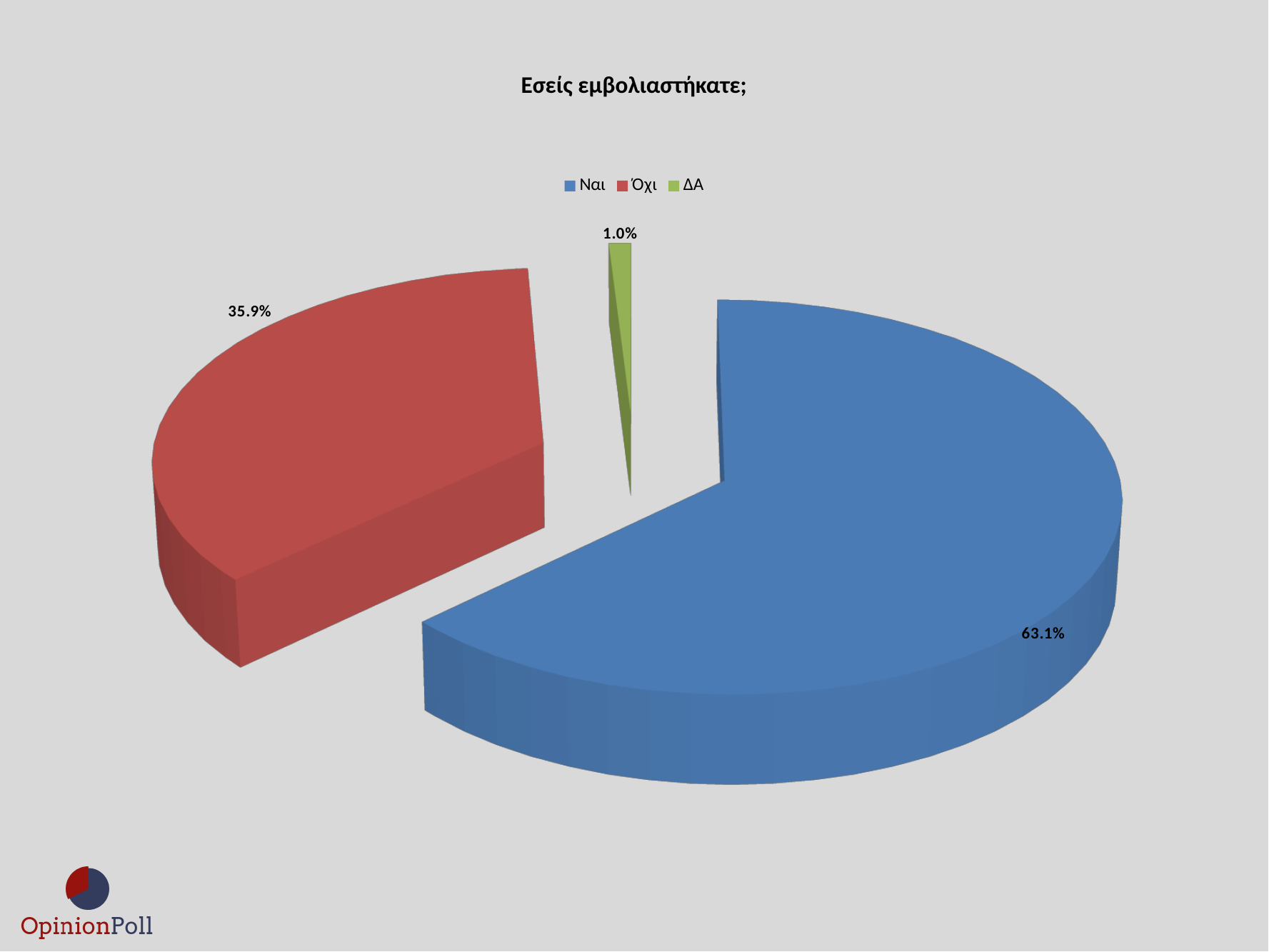
Which is larger, the Όχι slice or the ΔΑ slice? Όχι Which category has the smallest slice of the pie? ΔΑ Is the value for Ναι greater or less than 50%? greater How many categories does the legend list? 3 Which category has the largest slice of the pie? Ναι What is the difference in percentage points between the Ναι and Όχι slices? 27.2 What kind of chart is shown on the slide? pie chart What is the title of the chart? Εσείς εμβολιαστήκατε; What percentage of the pie is the Όχι slice? 35.9% What colour is the Όχι slice? red What percentage of the pie is the ΔΑ slice? 1.0% What percentage of the pie is the Ναι slice? 63.1%